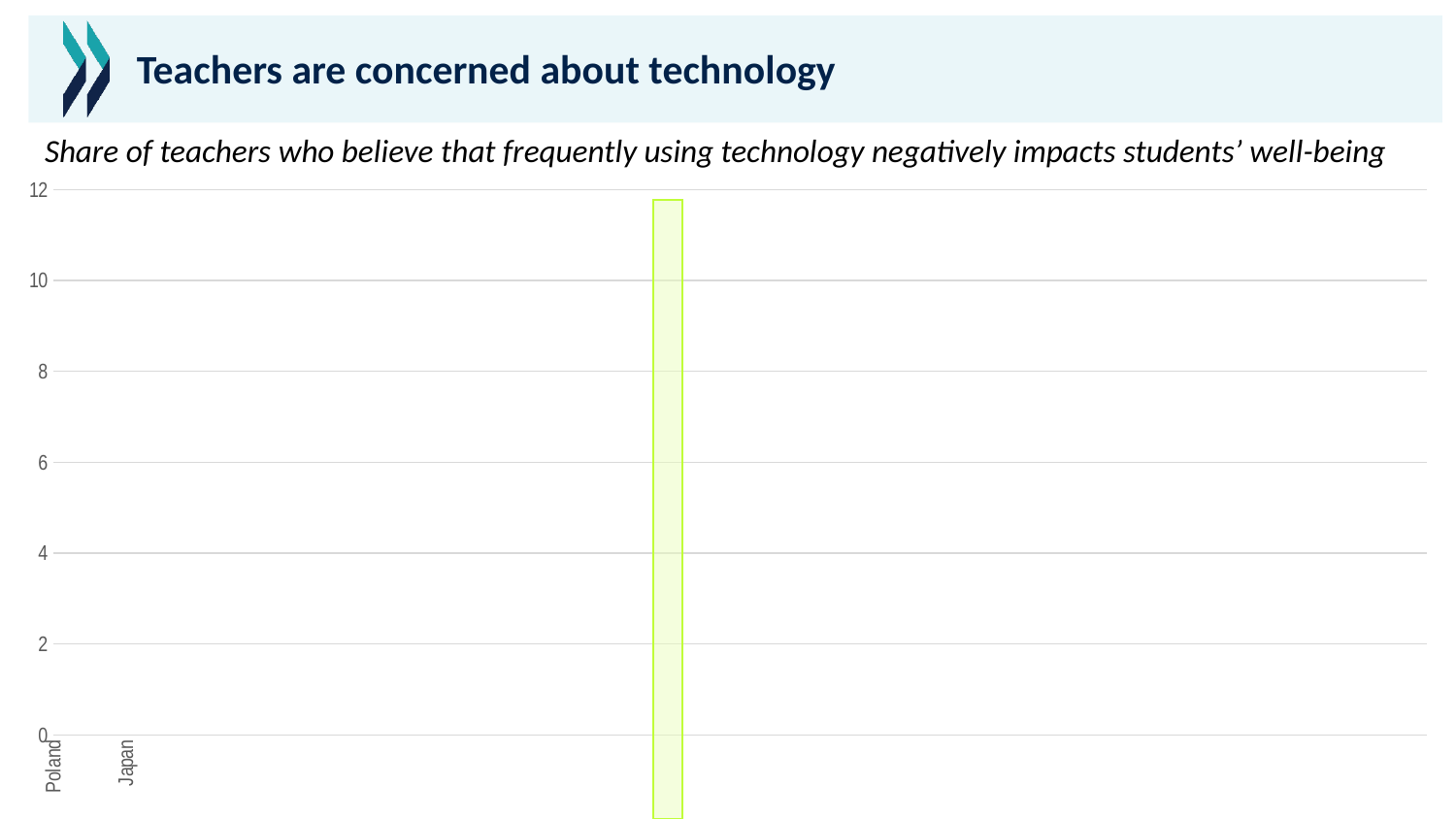
What kind of chart is shown on the slide? bar chart Is the value of the visible bar greater or less than 8? greater What is the title of the chart? Share of teachers who believe that frequently using technology negatively impacts students' well-being What is the highest value shown on the vertical axis? 12 Is the value of the visible bar greater or less than 10? greater